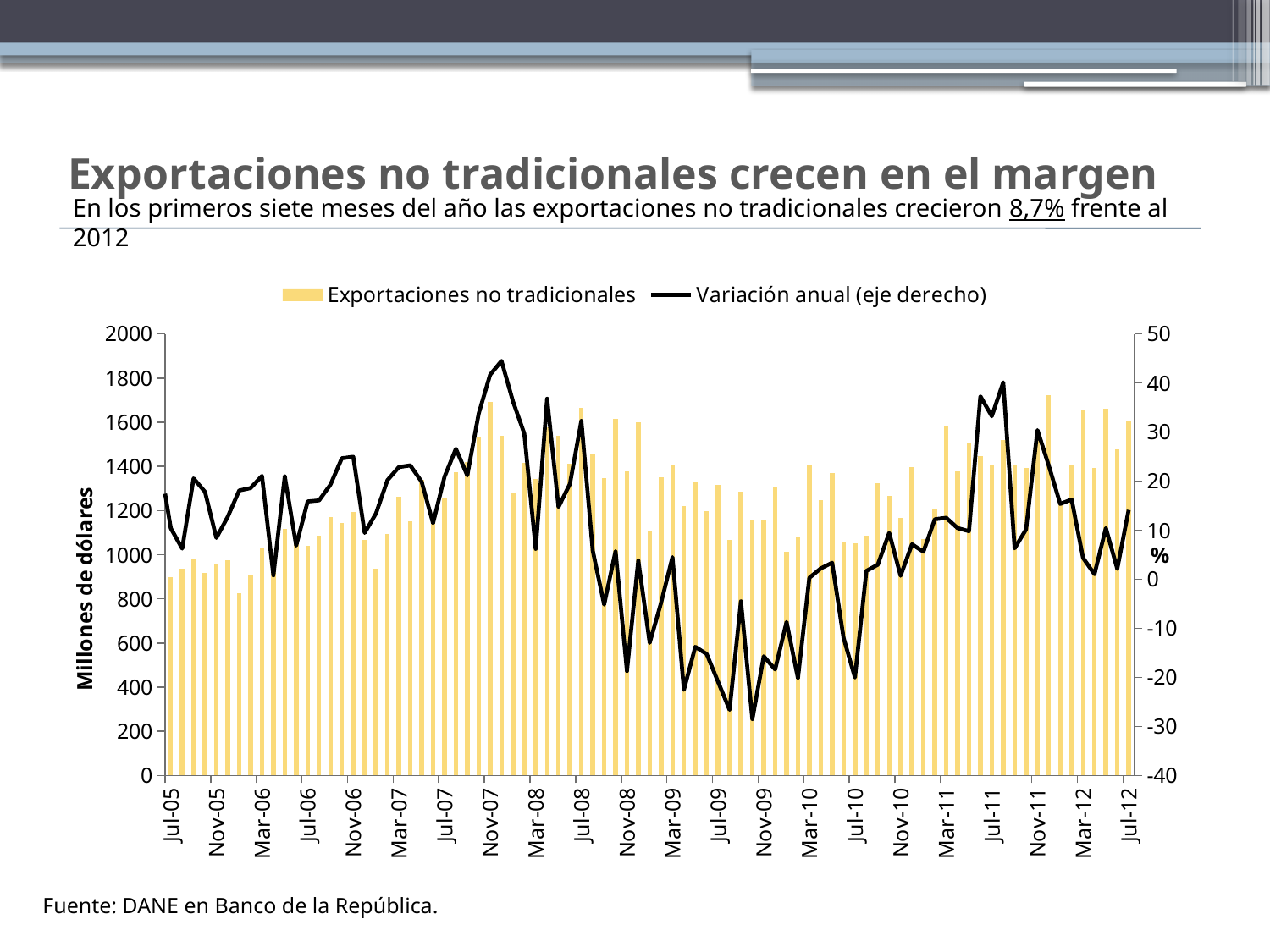
How many series does the legend list? 2 Is the value of the Exportaciones no tradicionales bar for Jul-05 greater or less than 1000? less Which series is plotted on the right-hand axis according to the legend? Variación anual (eje derecho) Does the Variación anual line generally rise or fall from Nov-07 to Jul-09? fall Is the value of the Exportaciones no tradicionales bar for Nov-07 greater or less than 1600? greater Is the Variación anual line value at Jul-11 greater or less than 30? greater Do the Exportaciones no tradicionales bars generally rise or fall from Jul-05 to Nov-07? rise What is the label of the left vertical axis? Millones de dólares What kind of chart is shown on the slide? A combined bar and line chart